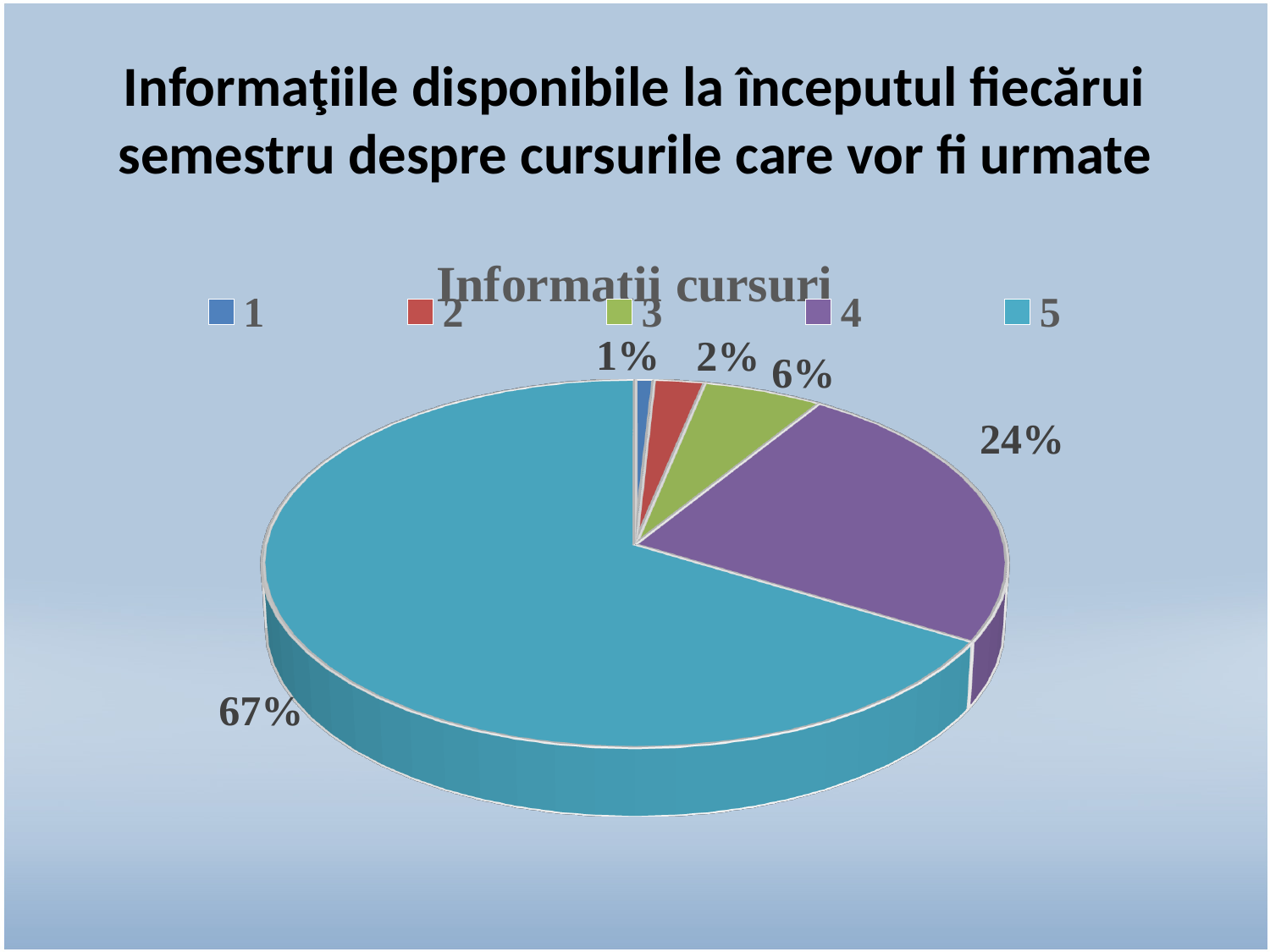
What share of the pie does category 5 have? 67% Which category has the smallest slice? 1 Which category has the largest slice? 5 What share of the pie does category 2 have? 2% How many categories does the legend list? 5 What is the title of the chart? Informatii cursuri Which is larger, the slice for category 3 or the slice for category 2? 3 What kind of chart is shown on the slide? pie chart What share of the pie does category 3 have? 6% What is the difference in percentage points between category 5 and category 4? 43